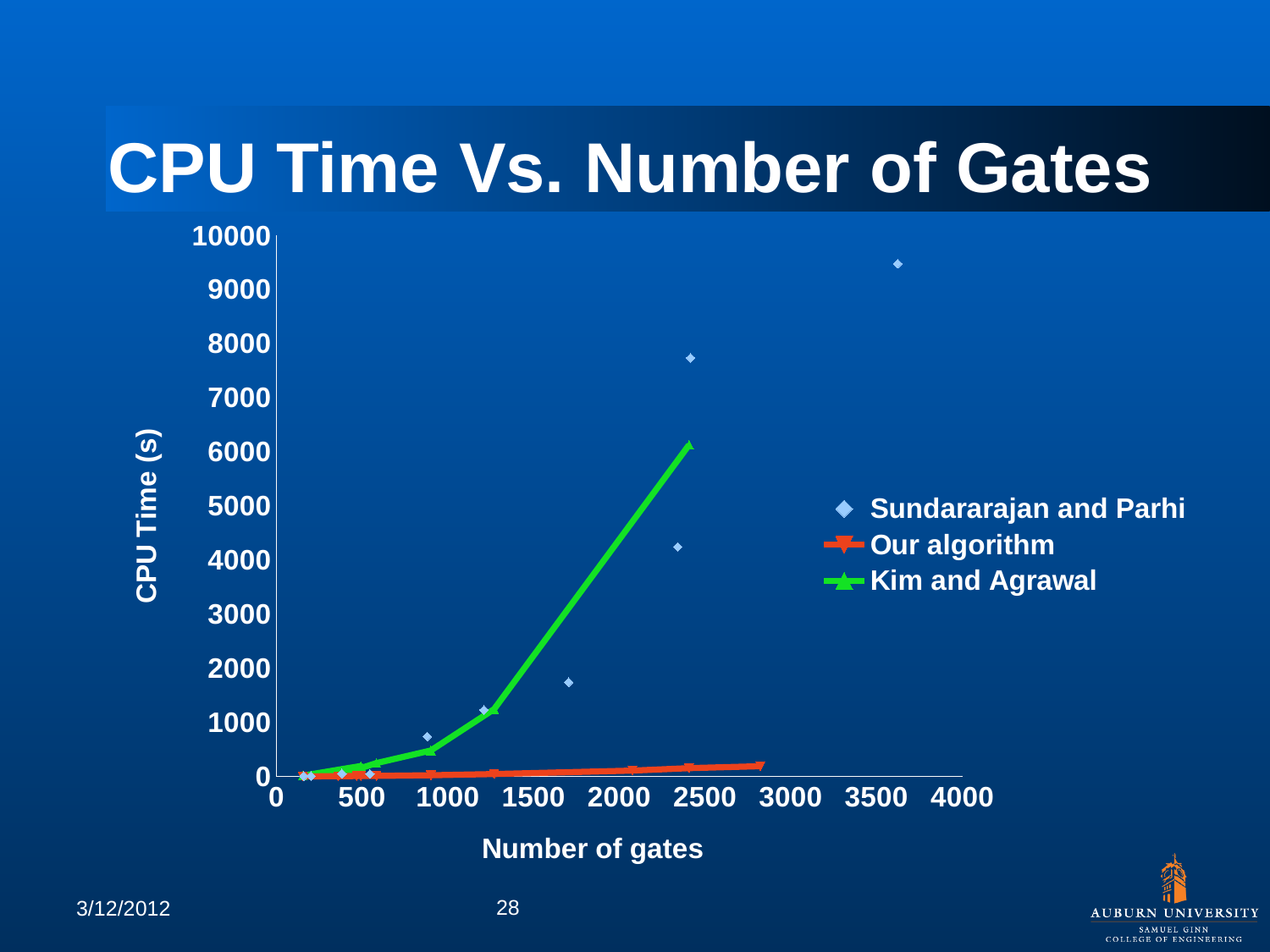
Which series has the lowest CPU time across the range of gates shown? Our algorithm What is the label of the y axis? CPU Time (s) Is the highest CPU time value for Sundararajan and Parhi greater or less than 9000? greater At around 2500 gates, which series has the larger CPU time: Kim and Agrawal or Our algorithm? Kim and Agrawal Is the highest CPU time value for Kim and Agrawal greater or less than 5000? greater What is the title of the chart? CPU Time Vs. Number of Gates Does the CPU time for Kim and Agrawal rise or fall as the number of gates increases? rise Which series reaches the highest CPU time on the chart? Sundararajan and Parhi How many series does the legend list? 3 What kind of chart is shown on the slide? line chart Is the highest CPU time value for Kim and Agrawal greater or less than 7000? less